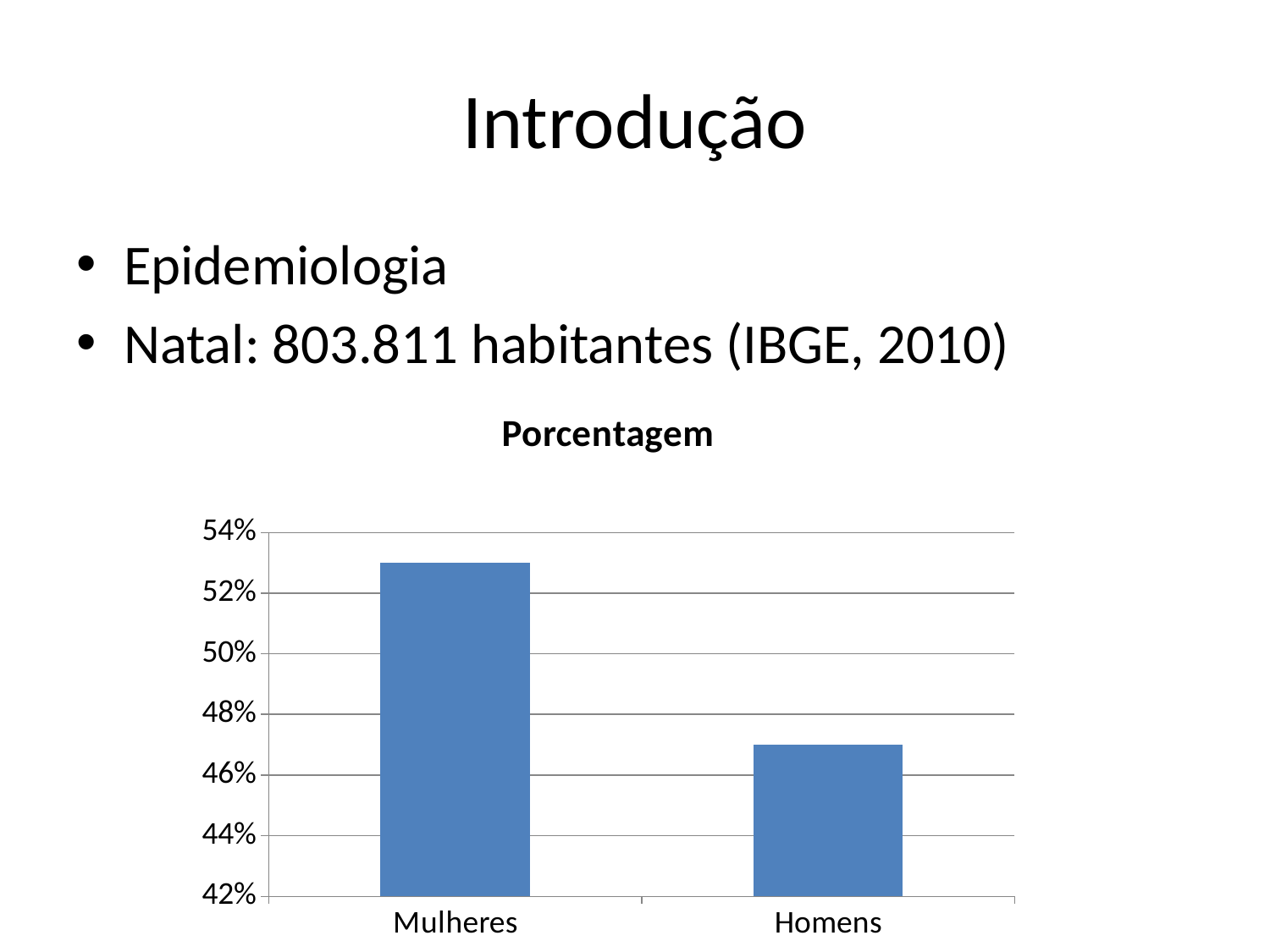
Which category has the highest value in the chart? Mulheres Which category has the lowest value in the chart? Homens What is the lowest value shown on the vertical axis of the chart? 42% Do the values rise or fall from Mulheres to Homens along the x axis? fall Is the value for Homens greater or less than 48%? less What kind of chart is shown on the slide? bar chart Is the value for Homens greater or less than 50%? less How many categories are shown on the x axis of the chart? 2 Is the value for Mulheres greater or less than 50%? greater Which is larger, the value for Mulheres or the value for Homens? Mulheres What is the title of the chart? Porcentagem